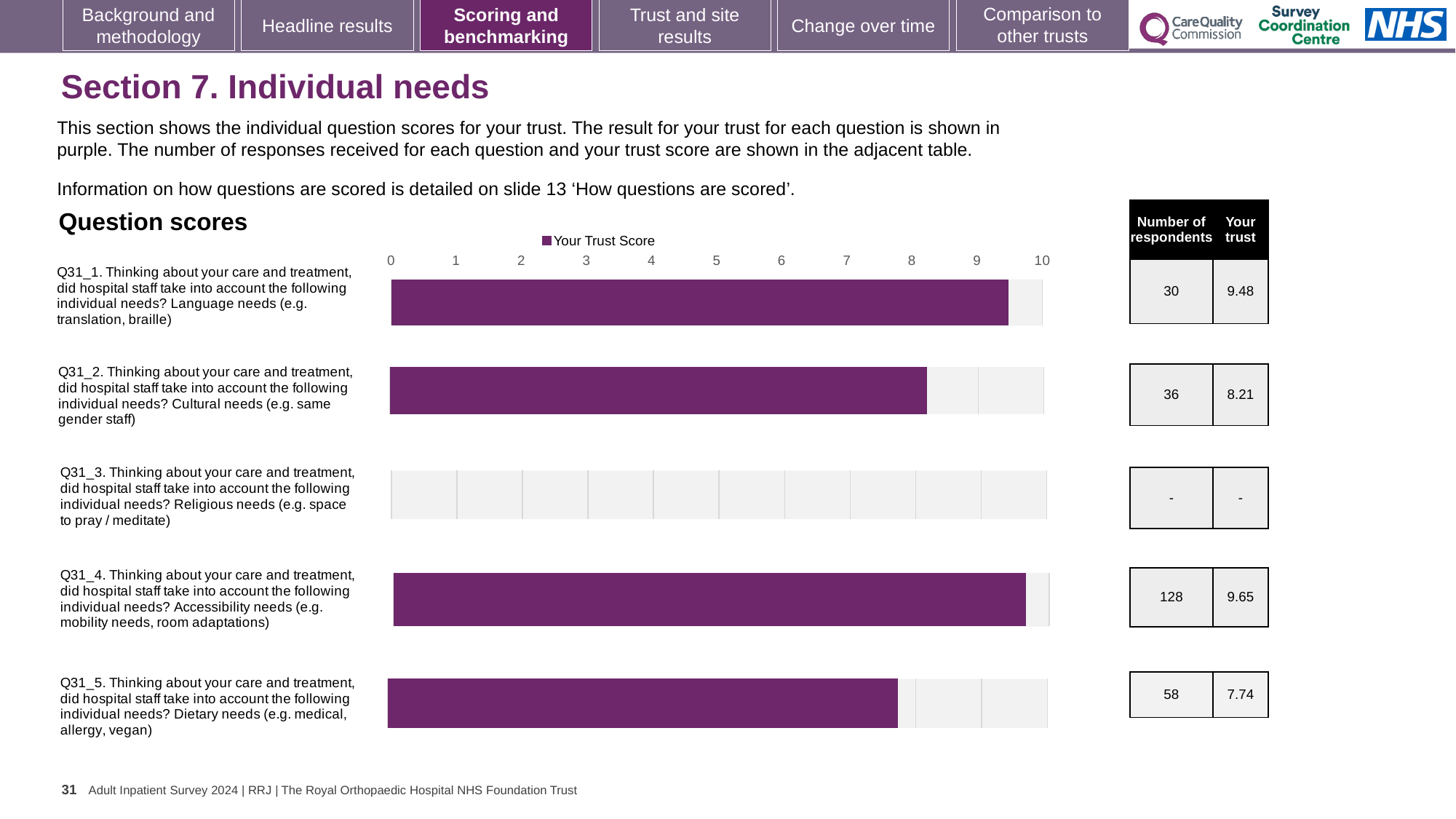
How many series does the legend list? 1 Which question has the highest trust score? Q31_4 (Accessibility needs) Is the trust score for Q31_2 greater or less than 9? less What is the name of the series shown in the legend? Your Trust Score What is the trust score for Q31_5 (Dietary needs)? 7.74 What kind of chart is shown? Bar chart How many questions are listed on the chart? 5 What is the difference between the trust scores for Q31_4 and Q31_2? 1.44 How many respondents answered Q31_4 (Accessibility needs)? 128 Among the questions with a plotted score, which has the lowest trust score? Q31_5 (Dietary needs) Which has a higher trust score, Q31_2 (Cultural needs) or Q31_5 (Dietary needs)? Q31_2 (Cultural needs) What is the trust score for Q31_1 (Language needs)? 9.48